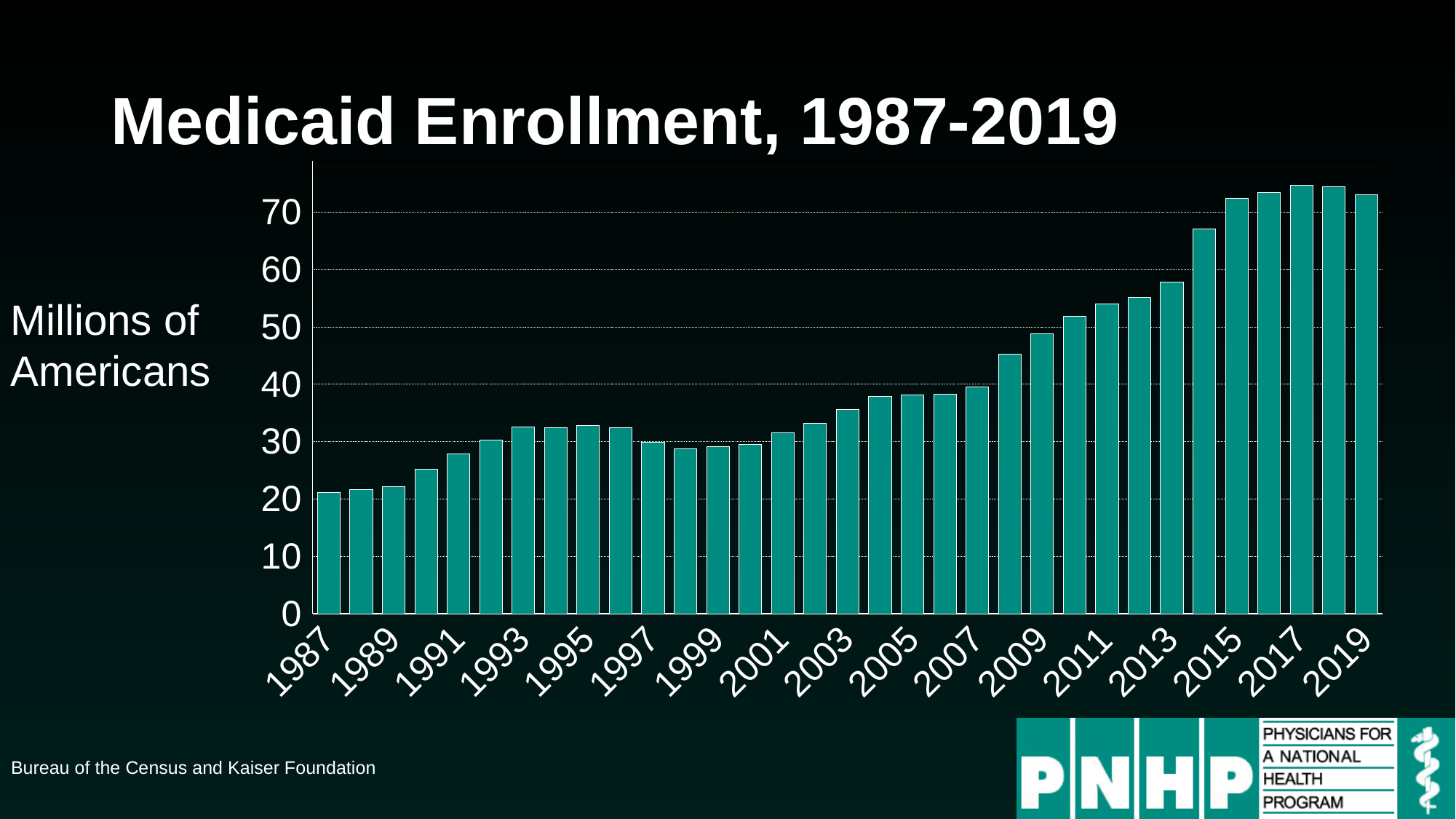
Is the value for 2019 greater or less than 70? greater Which year has the larger value, 1987 or 2019? 2019 Is the value for 1987 greater or less than 20? greater What kind of chart is shown on the slide? bar chart Is the value for 2005 greater or less than 40? less Overall, do the values rise or fall from 1987 to 2019? rise What is the title of the chart? Medicaid Enrollment, 1987-2019 In what units are the values on the chart expressed, according to the axis label? Millions of Americans Which year has the larger value, 1997 or 2007? 2007 How many bars (years) are plotted on the chart? 33